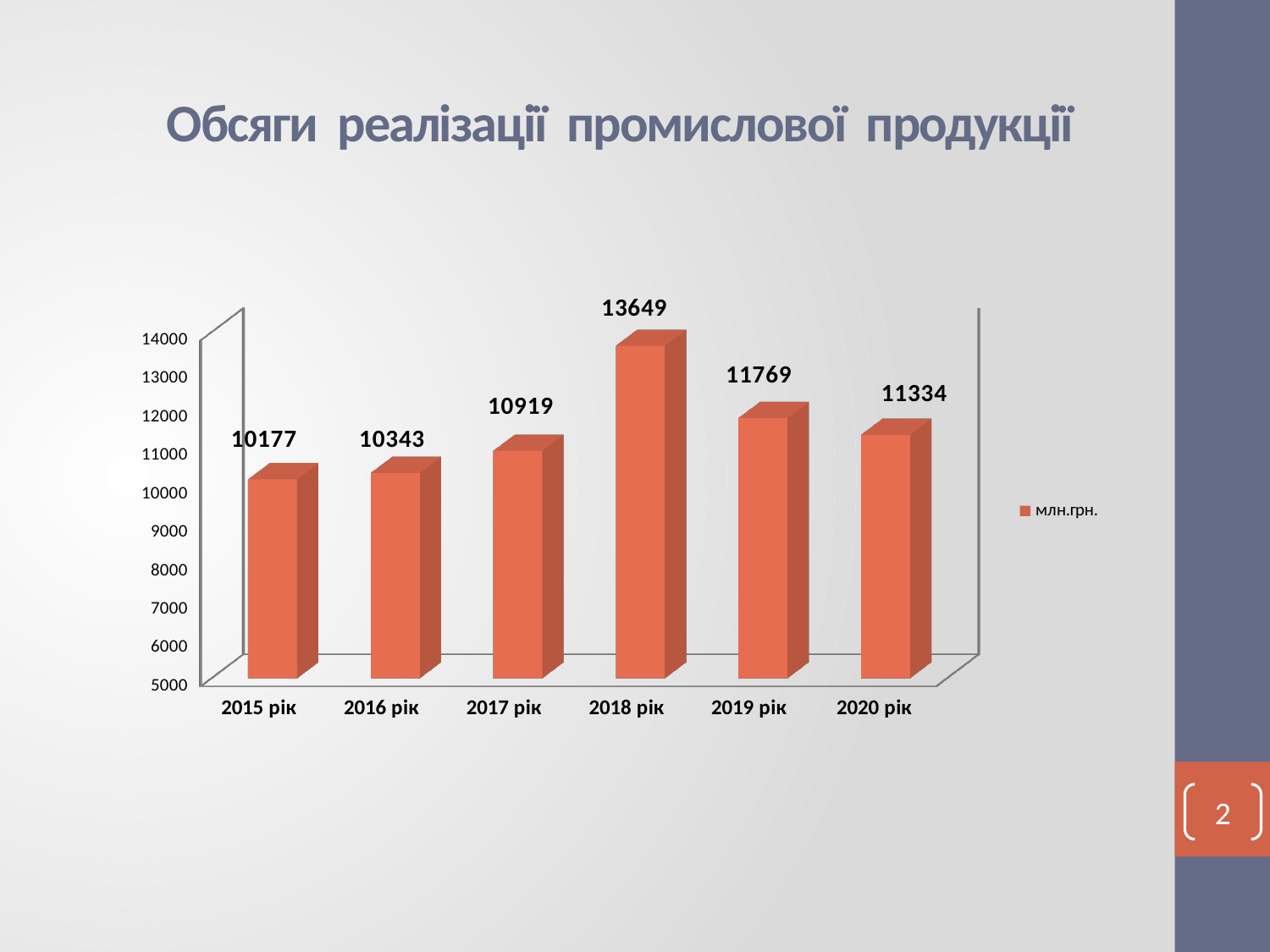
How many series does the legend list? 1 What is the value for 2020 рік? 11334 How many years are shown on the x axis? 6 What is the value for 2018 рік? 13649 What is the difference between the values for 2016 рік and 2015 рік? 166 Is the value for 2017 рік greater or less than 11000? less Which year has the lowest value? 2015 рік Which is larger, the value for 2019 рік or the value for 2020 рік? 2019 рік Which year has the highest value? 2018 рік What is the difference between the values for 2018 рік and 2019 рік? 1880 What kind of chart is shown on the slide? bar chart What is the value for 2015 рік? 10177